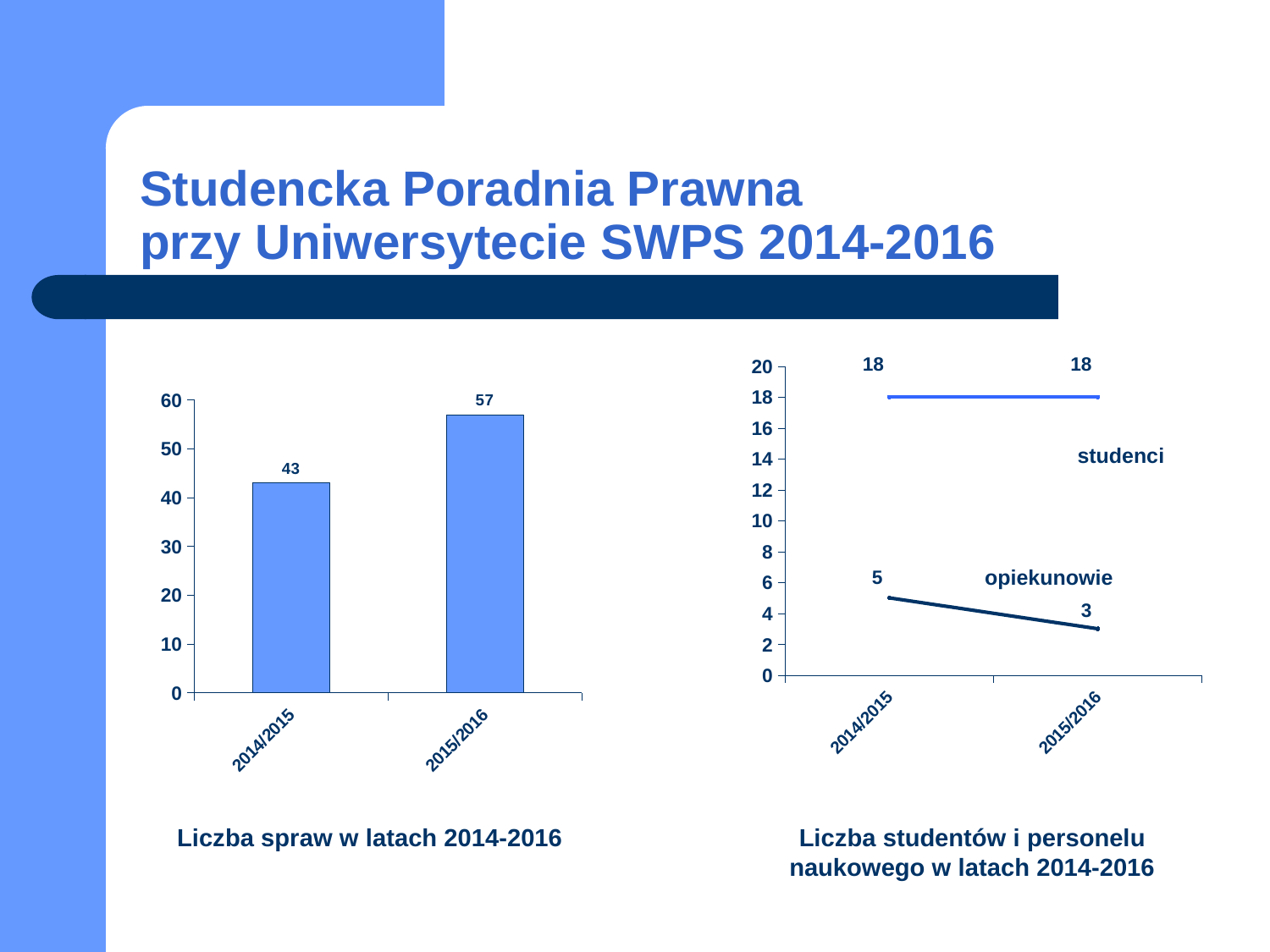
In the left chart (Liczba spraw w latach 2014-2016), what is the difference between the 2015/2016 and 2014/2015 values? 14 In the right chart (Liczba studentów i personelu naukowego w latach 2014-2016), what is the value for opiekunowie in 2014/2015? 5 What kind of chart is the right chart (Liczba studentów i personelu naukowego w latach 2014-2016)? line chart What kind of chart is the left chart (Liczba spraw w latach 2014-2016)? bar chart In the right chart (Liczba studentów i personelu naukowego w latach 2014-2016), does the opiekunowie line rise or fall from 2014/2015 to 2015/2016? fall In the left chart (Liczba spraw w latach 2014-2016), which year has the higher value? 2015/2016 In the left chart (Liczba spraw w latach 2014-2016), what is the value for 2014/2015? 43 In the right chart (Liczba studentów i personelu naukowego w latach 2014-2016), how many series are plotted? 2 In the right chart (Liczba studentów i personelu naukowego w latach 2014-2016), what is the value for studenci in 2015/2016? 18 In the right chart (Liczba studentów i personelu naukowego w latach 2014-2016), what is the value for opiekunowie in 2015/2016? 3 In the left chart (Liczba spraw w latach 2014-2016), what is the value for 2015/2016? 57 In the left chart (Liczba spraw w latach 2014-2016), do the values rise or fall from 2014/2015 to 2015/2016? rise